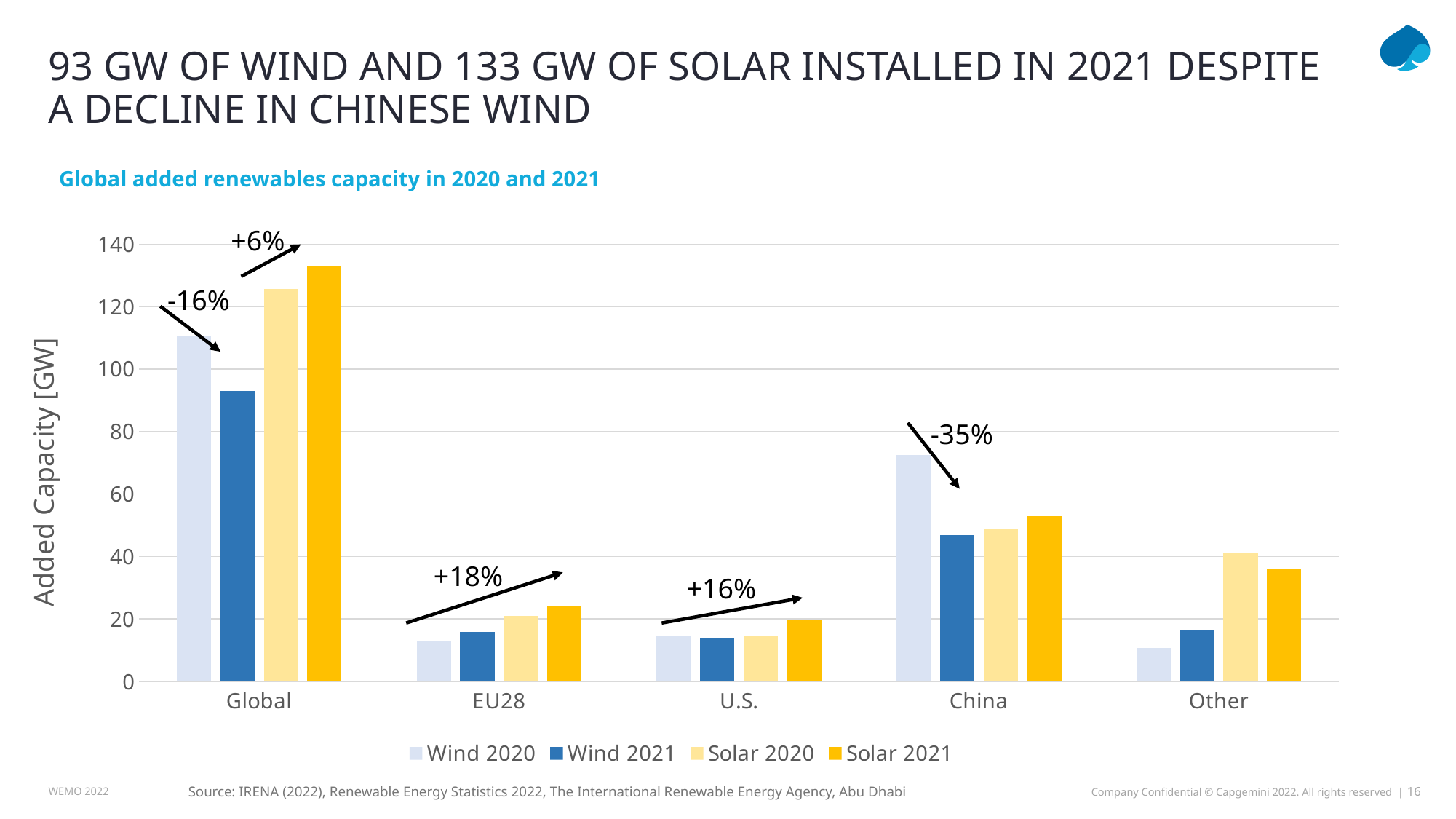
What kind of chart is shown on the slide? bar chart For Global, which is larger: Wind 2021 or Solar 2021? Solar 2021 Is the Solar 2021 value for Global greater or less than 120? greater Which category has the lowest Wind 2020 value? Other Is the Wind 2021 value for China greater or less than 60? less What is the title of the y axis? Added Capacity [GW] Is the Wind 2020 value for Global greater or less than 100? greater How many categories are shown on the x axis? 5 What percentage change is annotated above the China bars? -35% How many series does the legend list? 4 For Other, which is larger: Solar 2020 or Solar 2021? Solar 2020